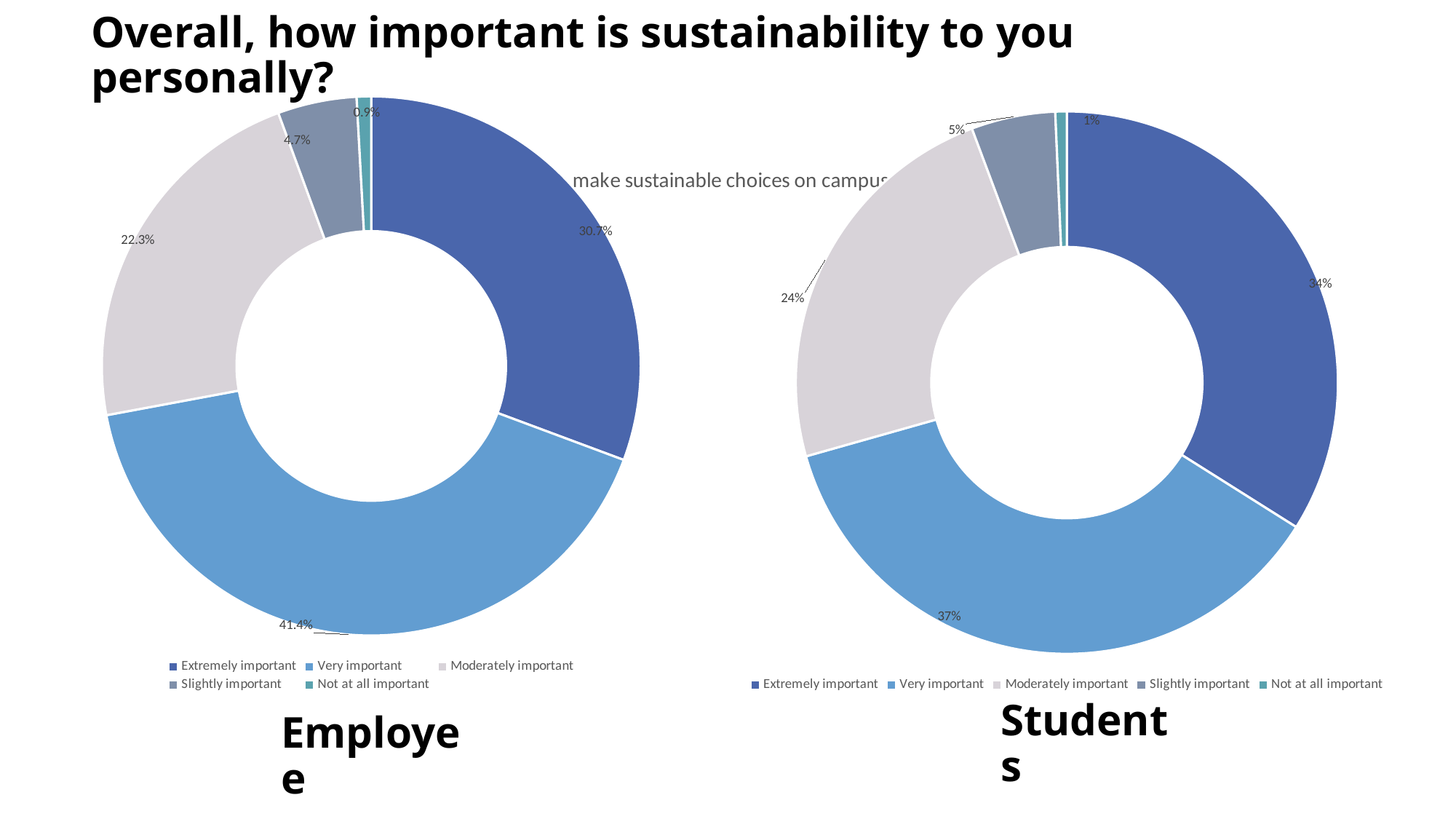
In the Students chart, what percentage of respondents said sustainability is Not at all important? 1% In the Students chart, which category has the smallest share? Not at all important In the Employee chart, what percentage of respondents said sustainability is Extremely important? 30.7% What kind of chart is the Students chart? Doughnut (pie) chart In the Employee chart, what percentage of respondents said sustainability is Very important? 41.4% What colour is the Moderately important slice in the Employee chart? Light grey In the Employee chart, what is the difference between the Very important and Extremely important shares? 10.7% Which is larger in the Students chart: the Extremely important share or the Moderately important share? Extremely important In the Students chart, what percentage of respondents said sustainability is Moderately important? 24% In the Employee chart, which category has the largest share? Very important In the Students chart, what is the difference between the Very important and Moderately important shares? 13% How many categories does the legend of the Employee chart list? 5